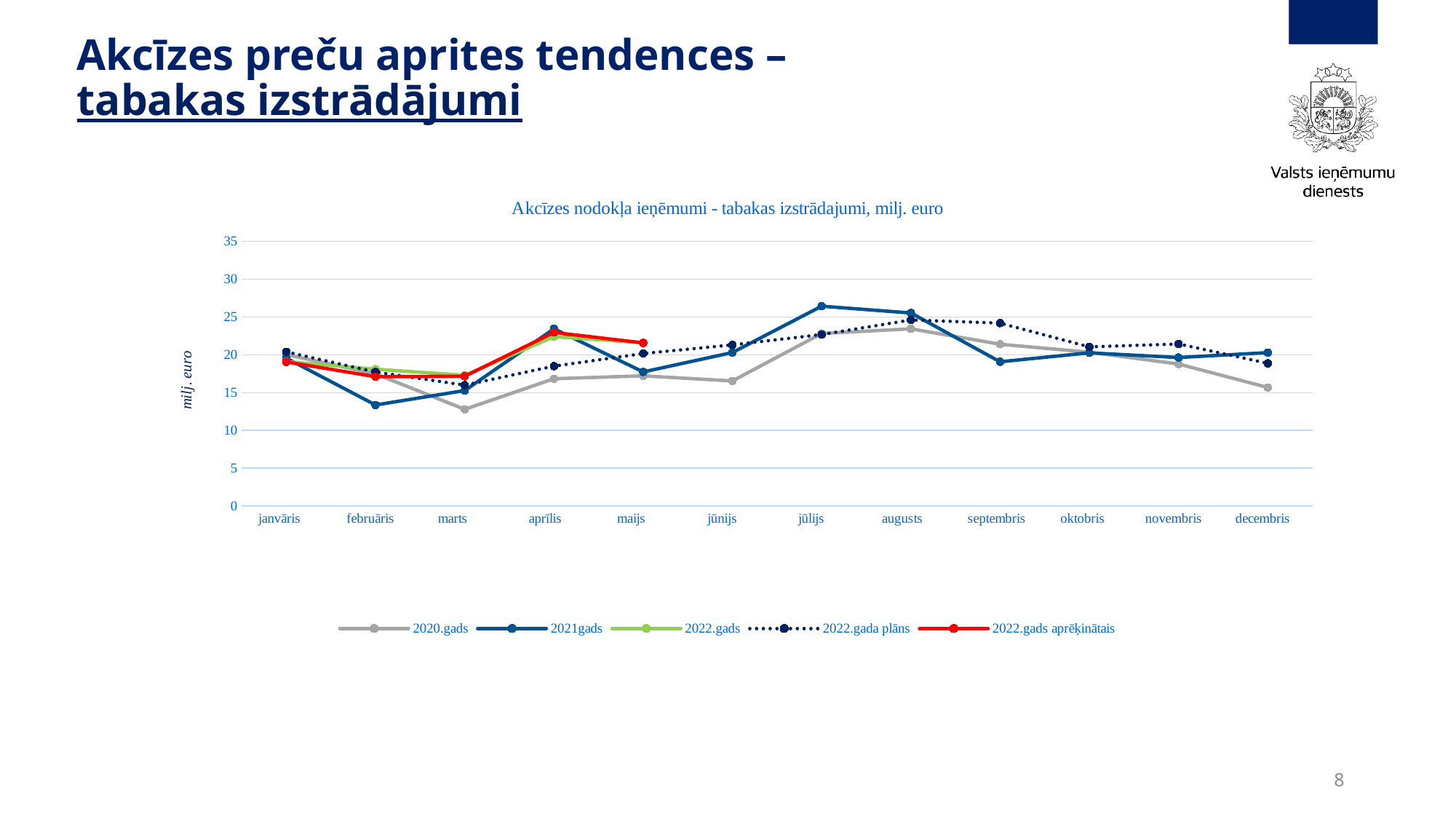
In which month does the 2020.gads series reach its lowest value? marts In which month does the 2021.gads series reach its lowest value? februāris In which month does the 2021.gads series reach its highest value? jūlijs Is the value for 2020.gads in marts greater or less than 15? less How many months are shown along the x axis? 12 What kind of chart is shown on the slide? line chart Is the value for 2021.gads in jūlijs greater or less than 25? greater Is the value for 2022.gada plāns in septembris greater or less than 20? greater Does the 2020.gads series rise or fall from augusts to decembris? fall In februāris, which series has the larger value: 2020.gads or 2021.gads? 2020.gads How many series does the legend list? 5 In aprīlis, which series has the larger value: 2020.gads or 2021.gads? 2021.gads